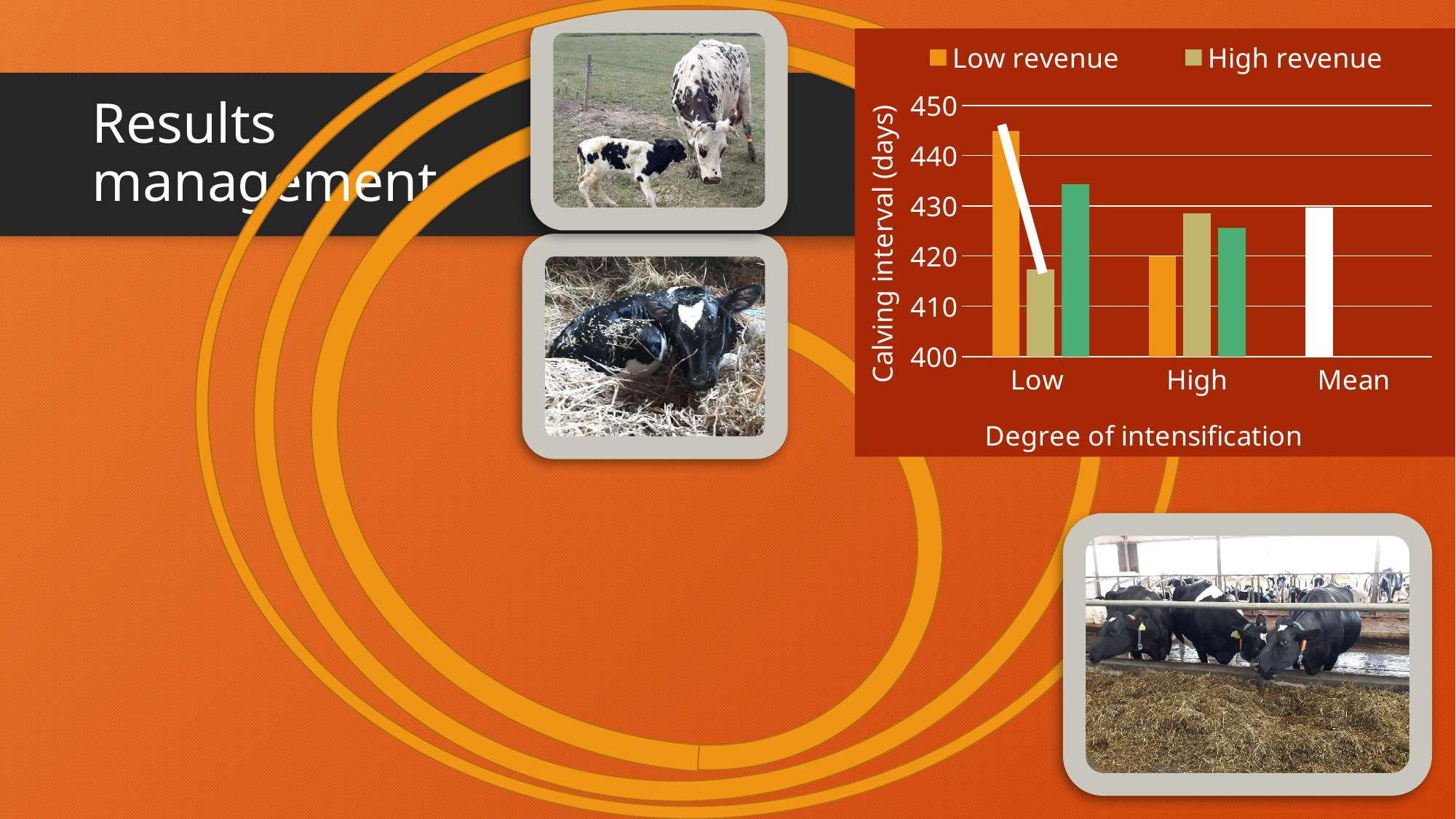
What kind of chart is shown on the slide? bar chart Which bar in the chart is the lowest? High revenue in the Low category Is the Low revenue value for the Low category greater or less than 440? greater In the Low category, which is larger: the Low revenue bar or the High revenue bar? Low revenue How many series does the chart legend list? 2 Does the Low revenue series rise or fall from the Low category to the High category? fall What is the title of the y axis of the chart? Calving interval (days) How many categories are shown on the x axis of the chart? 3 Is the High revenue value for the Low category greater or less than 420? less Is the High revenue value for the High category greater or less than 420? greater In the High category, which is larger: the Low revenue bar or the High revenue bar? High revenue What is the title of the x axis of the chart? Degree of intensification